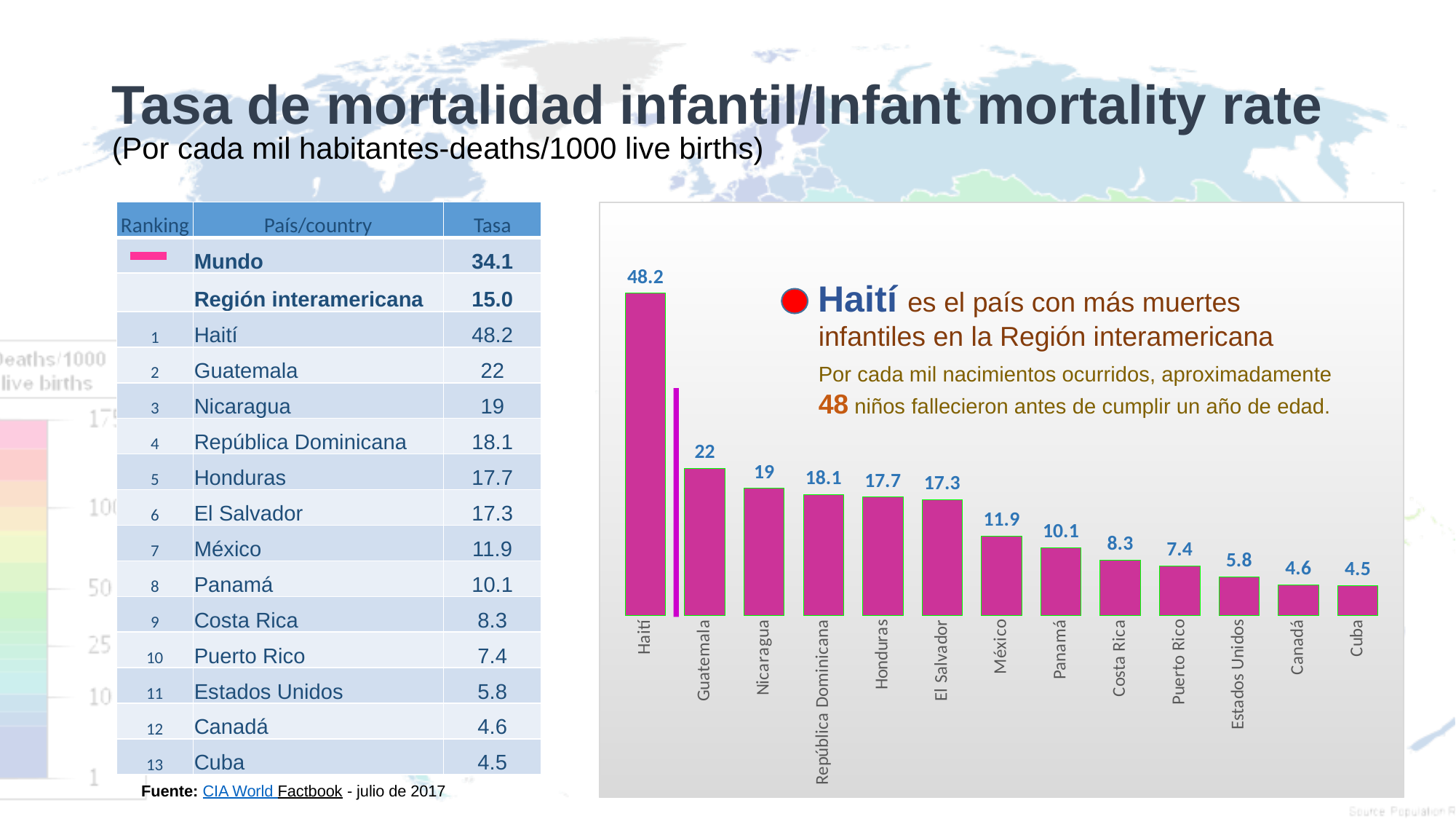
Which country has the highest bar in the chart? Haití What value is shown for Estados Unidos in the bar chart? 5.8 What is the value labeled for República Dominicana in the bar chart? 18.1 What is the infant mortality rate shown for Haití in the bar chart? 48.2 Which country has the lowest value in the bar chart? Cuba In the bar chart, which has a larger value, México or Panamá? México Do the values in the bar chart rise or fall from left to right? Fall How many countries are labeled on the x axis of the bar chart? 13 What value does the bar chart show for Guatemala? 22 What is the difference between the values for Honduras and El Salvador in the bar chart? 0.4 What is the difference between the values for Haití and Guatemala in the bar chart? 26.2 What kind of chart is shown on the right side of the slide? Bar chart